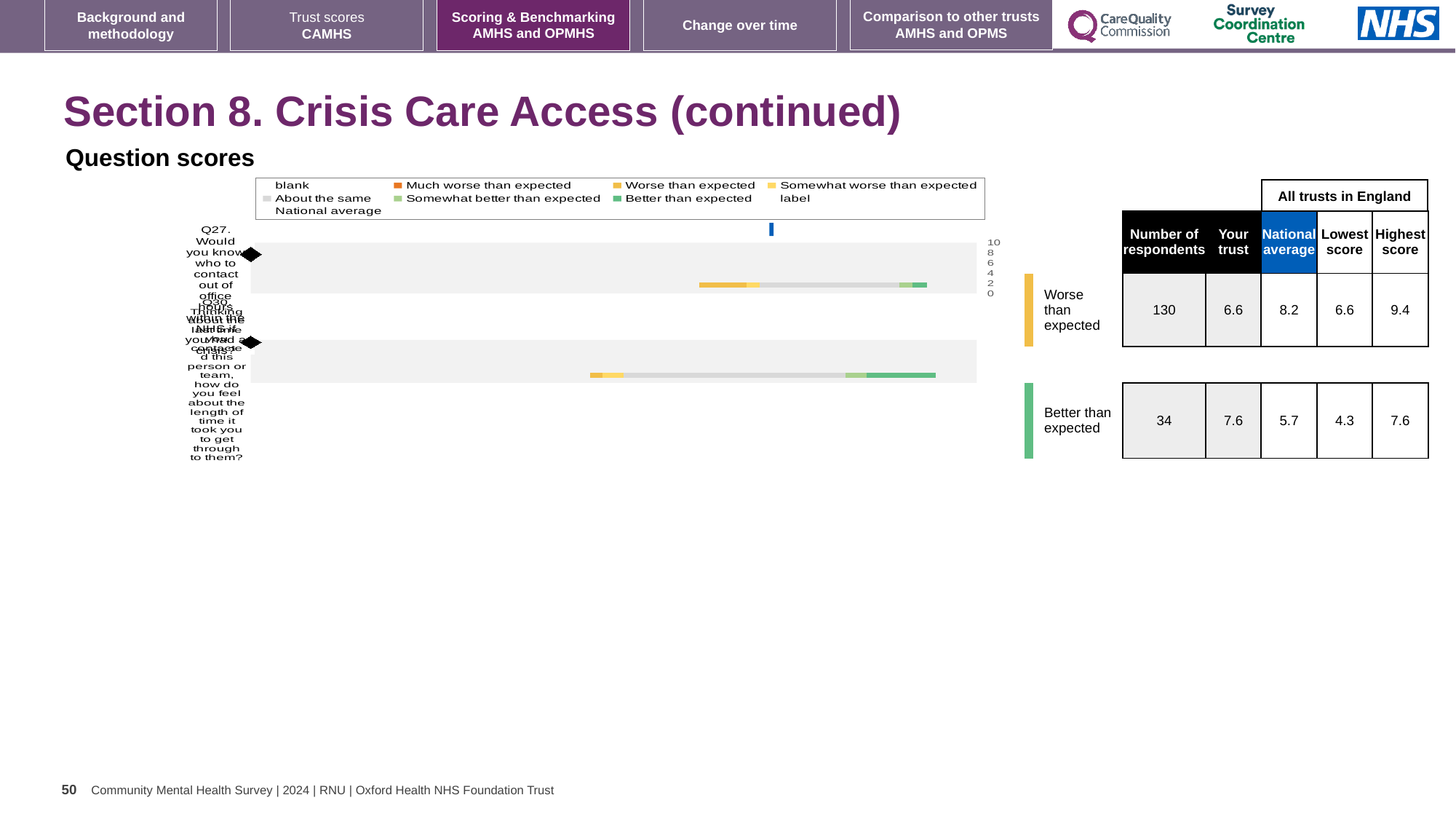
How many entries does the legend of the Question scores chart list? 9 What is the difference between the national average and the trust's score for Q27? 1.6 Which question in the chart is rated "Better than expected"? Q30 How many respondents answered Q30? 34 What is the trust's score for Q27 (knowing who to contact out of office hours)? 6.6 Which question in the chart is rated "Worse than expected"? Q27 What is the trust's score for Q30 (length of time to get through to the crisis contact)? 7.6 What is the national average score for Q27? 8.2 How many questions (bars) are plotted in the Question scores chart? 2 What is the highest score among all trusts in England for Q27? 9.4 What kind of chart is shown under "Question scores"? bar chart For Q30, which is larger: the trust's score or the national average? the trust's score